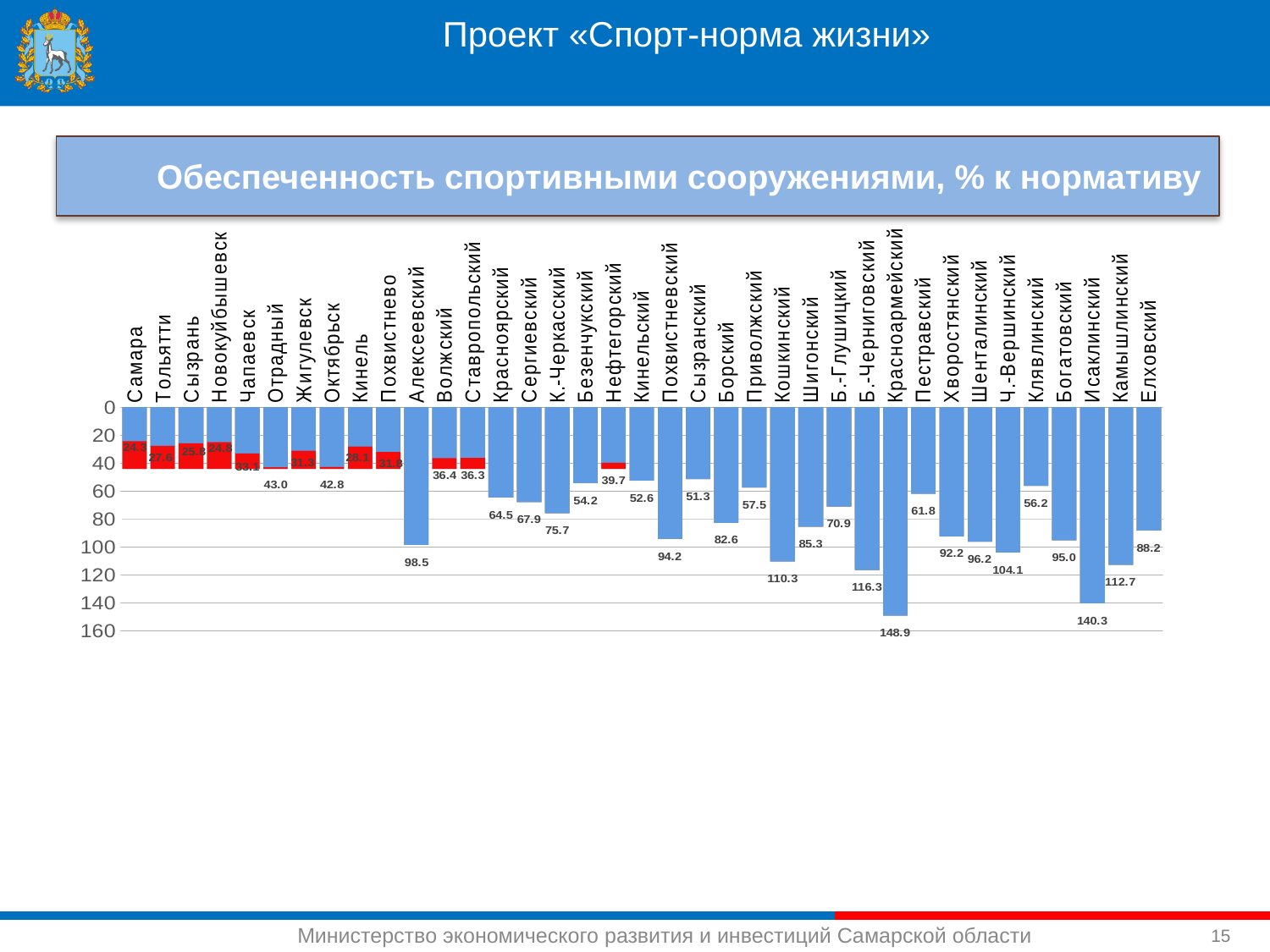
Which category has the highest value? Красноармейский What is the difference between the values for Камышлинский and Кошкинский? 2.4 What is the value for Алексеевский? 98.5 What is the difference between the values for Красноармейский and Исаклинский? 8.6 What kind of chart is shown on the slide? bar chart What is the value for Кошкинский? 110.3 Is the value for Б.-Черниговский greater or less than 100? greater What is the value for Елховский? 88.2 What is the value for Исаклинский? 140.3 What is the title of the chart? Обеспеченность спортивными сооружениями, % к нормативу What is the value for Отрадный? 43.0 Which is larger, the value for Борский or the value for Шигонский? Шигонский